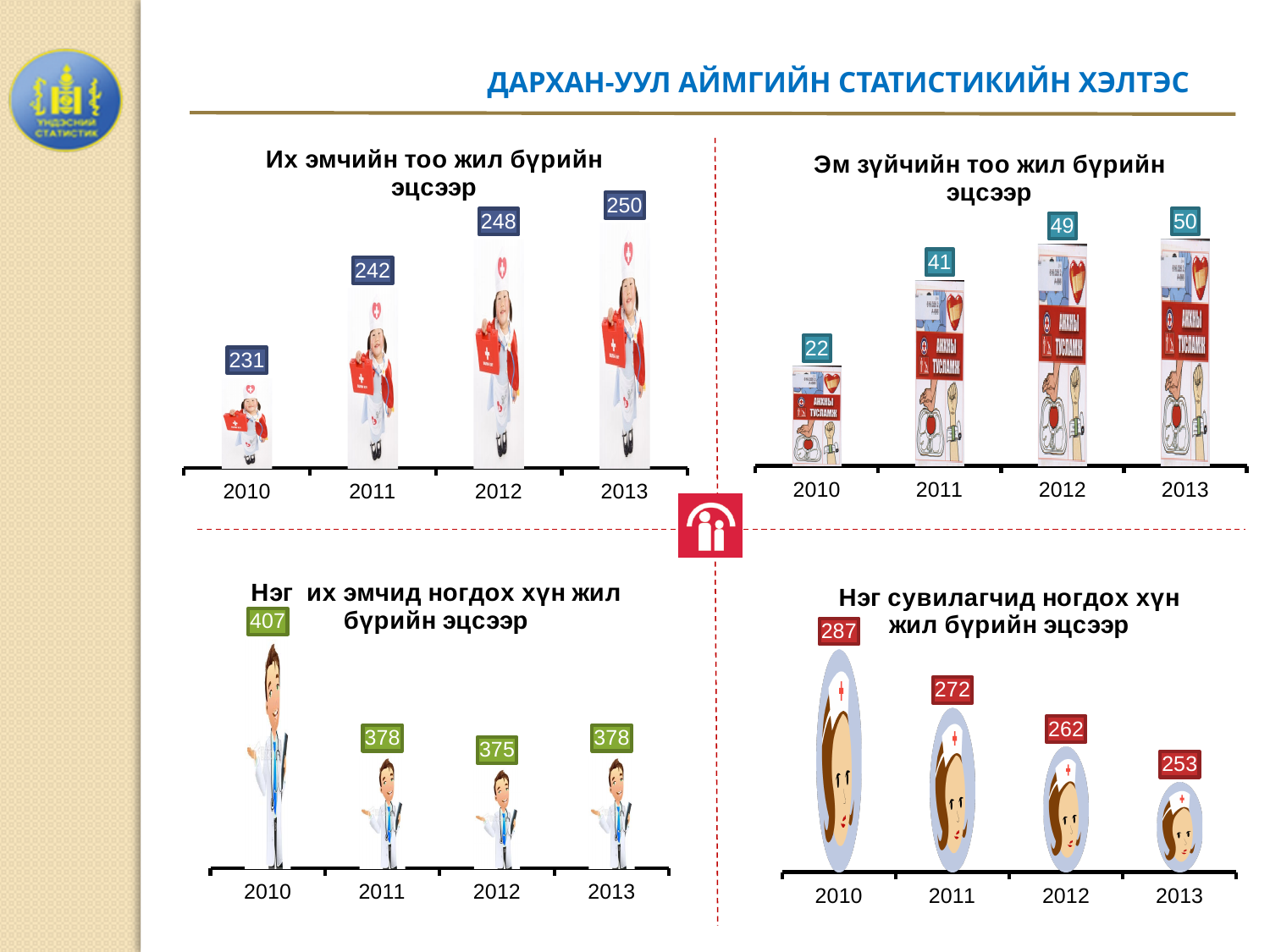
In the bottom-left chart (Нэг их эмчид ногдох хүн жил бүрийн эцсээр), what is the value for 2010? 407 In the top-right chart (Эм зүйчийн тоо жил бүрийн эцсээр), which year has the lowest value? 2010 In the bottom-right chart (Нэг сувилагчид ногдох хүн жил бүрийн эцсээр), do the values rise or fall from 2010 to 2013? fall In the top-right chart (Эм зүйчийн тоо жил бүрийн эцсээр), do the values rise or fall from 2010 to 2013? rise In the top-left chart (Их эмчийн тоо жил бүрийн эцсээр), what is the difference between the 2013 and 2010 values? 19 In the bottom-right chart (Нэг сувилагчид ногдох хүн жил бүрийн эцсээр), what is the value for 2013? 253 In the top-left chart (Их эмчийн тоо жил бүрийн эцсээр), what is the value for 2010? 231 In the bottom-right chart (Нэг сувилагчид ногдох хүн жил бүрийн эцсээр), what is the difference between the 2010 and 2011 values? 15 In the top-right chart (Эм зүйчийн тоо жил бүрийн эцсээр), what is the value for 2011? 41 How many years are shown on the x axis of the top-left chart (Их эмчийн тоо жил бүрийн эцсээр)? 4 In the top-left chart (Их эмчийн тоо жил бүрийн эцсээр), which year has the highest value? 2013 In the bottom-left chart (Нэг их эмчид ногдох хүн жил бүрийн эцсээр), which year has the lowest value? 2012